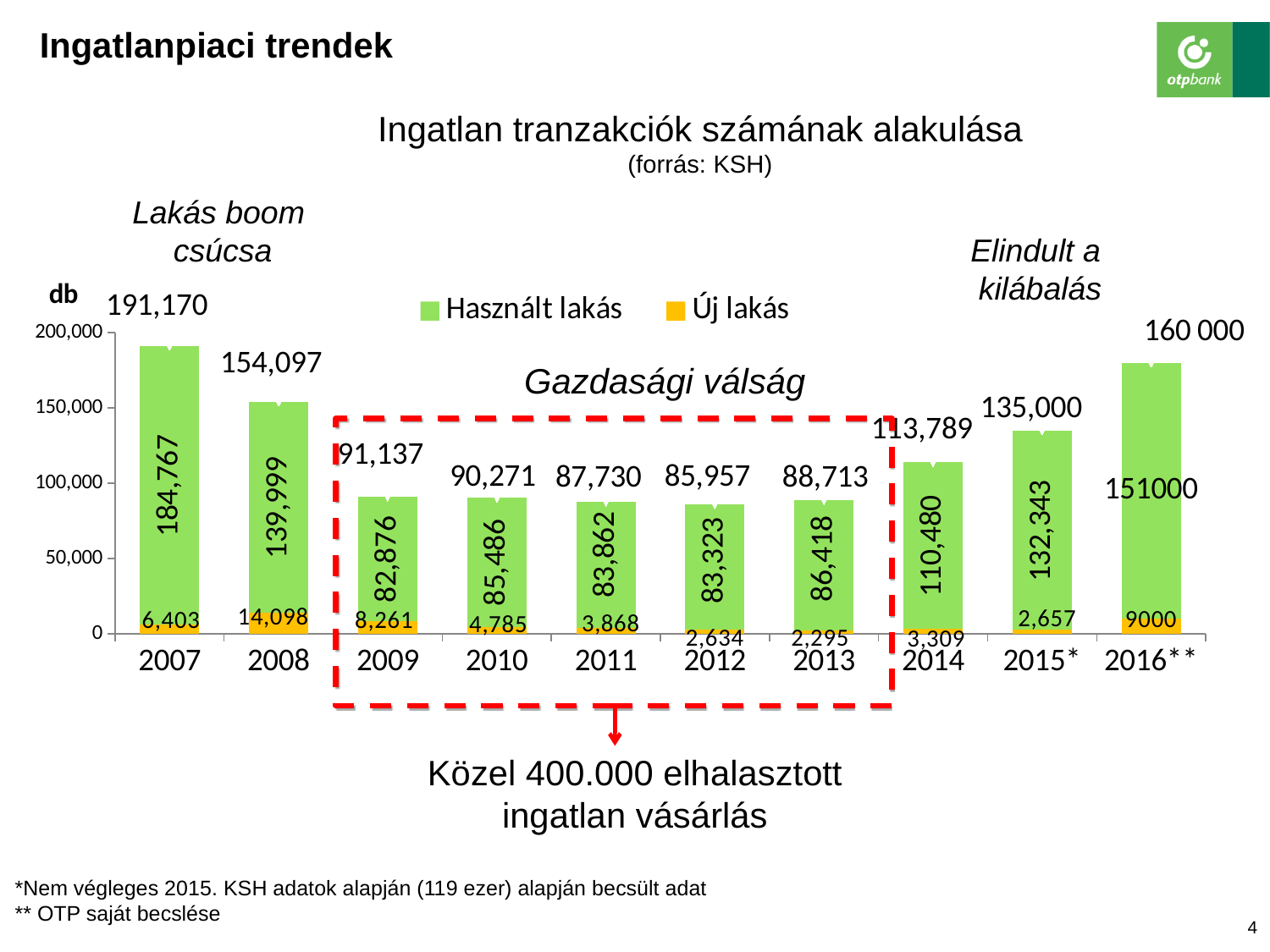
Which is larger, the Használt lakás value for 2010 or for 2011? 2010 What is the total shown above the bar for 2014? 113,789 What is the difference between the Használt lakás values for 2007 and 2008? 44,768 Which year has the lowest value for Új lakás? 2013 What is the total of the stacked bar for 2009? 91,137 Is the total for 2015* greater or less than 100,000? greater What is the value for Új lakás in 2008? 14,098 What is the value for Használt lakás in 2007? 184,767 Which year has the highest total number of transactions? 2007 How many series does the legend list? 2 How many years are shown on the x axis? 10 What kind of chart is shown on the slide? stacked bar chart